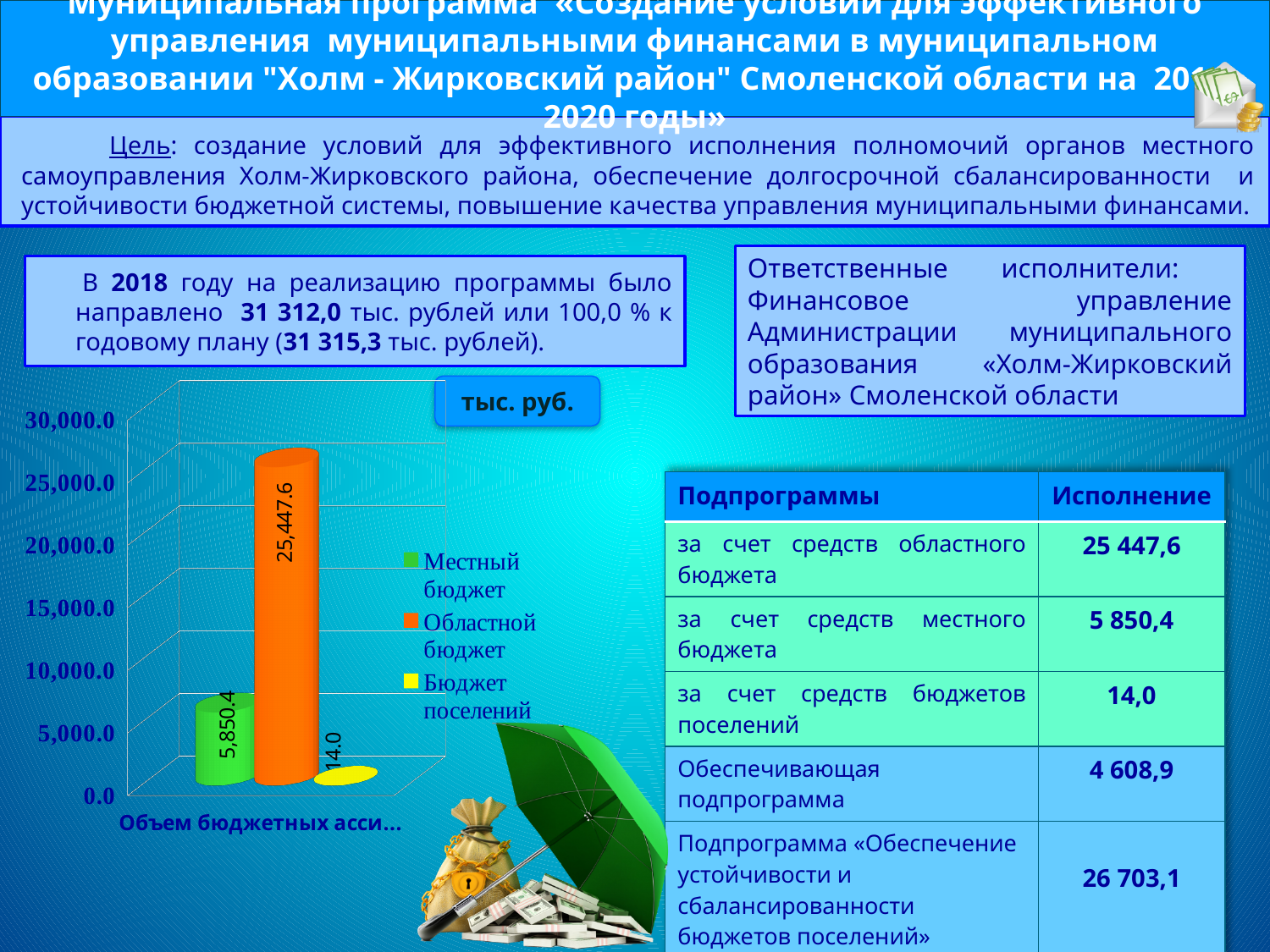
What is the difference between the values for Областной бюджет and Местный бюджет? 19,597.2 Is the value for Областной бюджет greater or less than 20,000.0? greater What unit is shown in the label box above the chart? тыс. руб. Which is larger, the value for Местный бюджет or the value for Бюджет поселений? Местный бюджет How many series does the chart legend list? 3 What is the value for Местный бюджет in the chart? 5,850.4 Is the value for Местный бюджет greater or less than 10,000.0? less What type of chart is shown on the slide? bar chart What is the value for Бюджет поселений in the chart? 14.0 Which series has the lowest value in the chart? Бюджет поселений What is the value for Областной бюджет in the chart? 25,447.6 Which series has the highest value in the chart? Областной бюджет